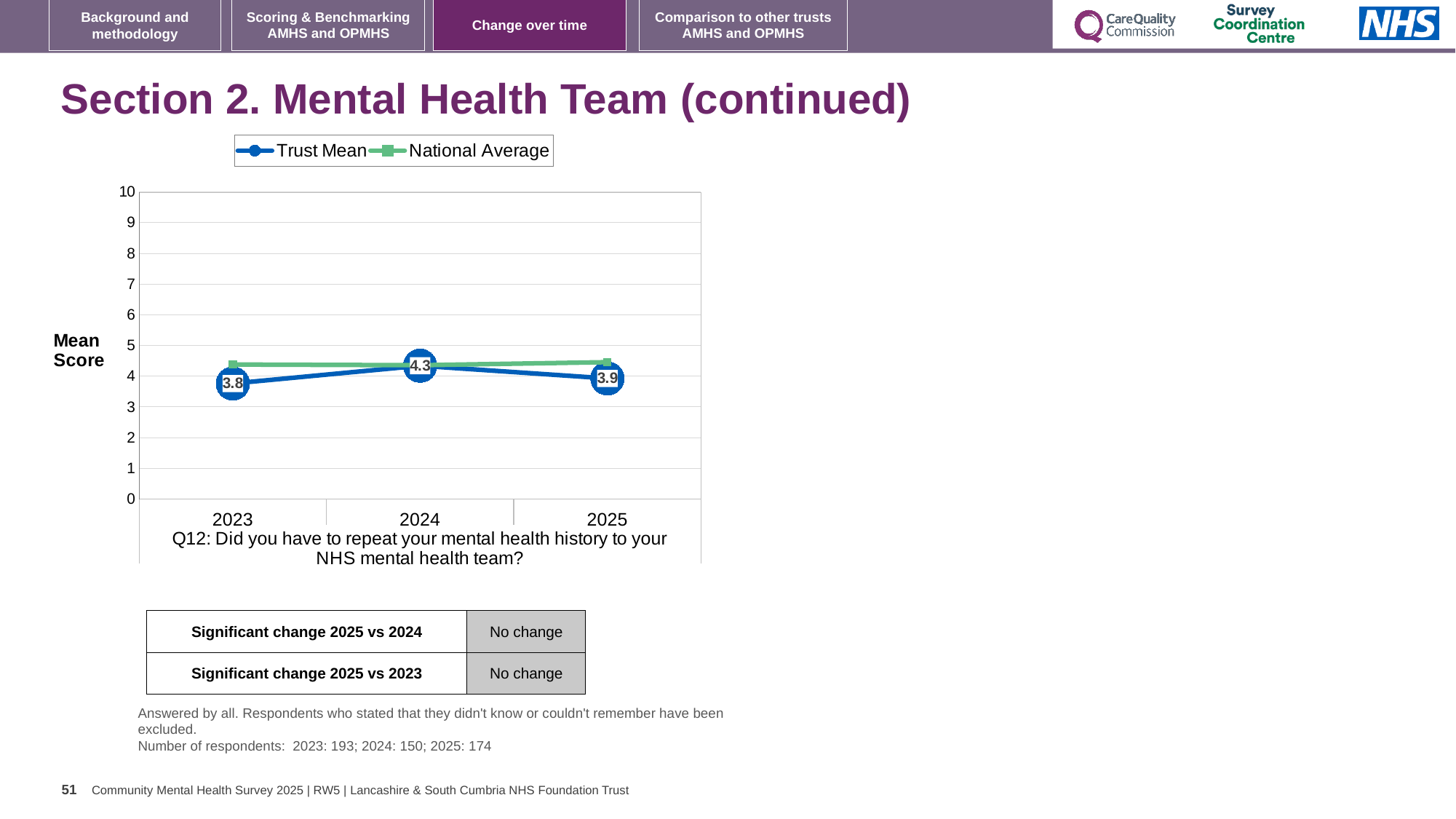
What is the Trust Mean value for 2023? 3.8 How many years are plotted on the x axis? 3 In which year is the Trust Mean highest? 2024 Which is larger, the Trust Mean in 2025 or the Trust Mean in 2023? 2025 What is the difference between the Trust Mean in 2024 and in 2023? 0.5 In which year is the Trust Mean lowest? 2023 What is the Trust Mean value for 2025? 3.9 Is the National Average value for 2025 greater or less than 4? greater What kind of chart is shown on the slide? Line chart Does the Trust Mean rise or fall from 2024 to 2025? Fall How many series does the legend list? 2 What is the Trust Mean value for 2024? 4.3